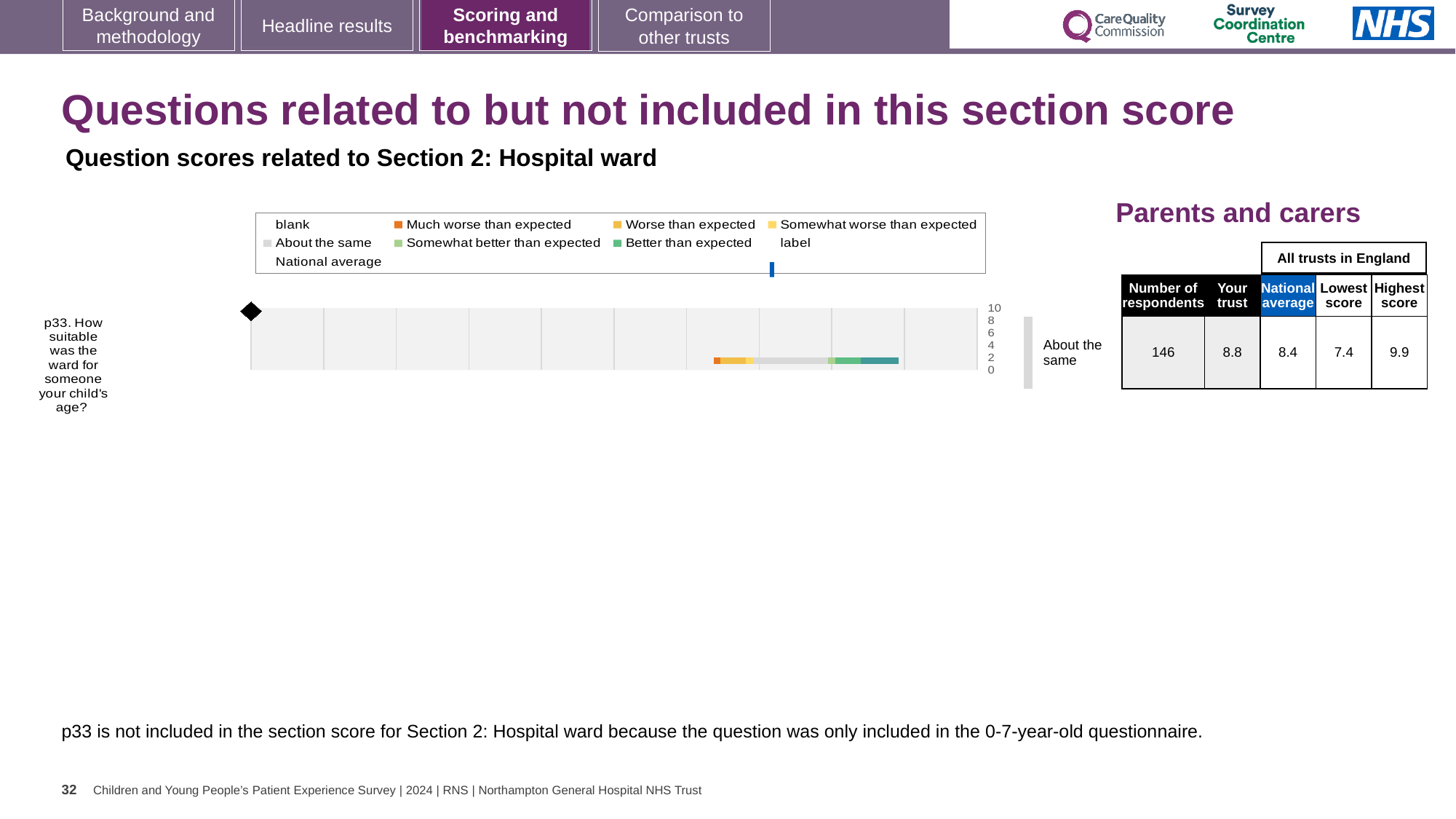
Which legend entry is shown in orange? Much worse than expected How many questions are plotted in the chart? 1 What is the national average score for p33? 8.4 What benchmark category is shown next to the bar for p33? About the same What is the difference between the highest and lowest trust scores for p33? 2.5 What is the 'Your trust' score for p33? 8.8 Which is higher for p33, the 'Your trust' score or the national average? Your trust What is the lowest score among all trusts in England for p33? 7.4 What is the highest score among all trusts in England for p33? 9.9 Which question is plotted in the chart? p33. How suitable was the ward for someone your child's age? How many respondents answered p33? 146 What kind of chart is used to show the p33 question score? bar chart